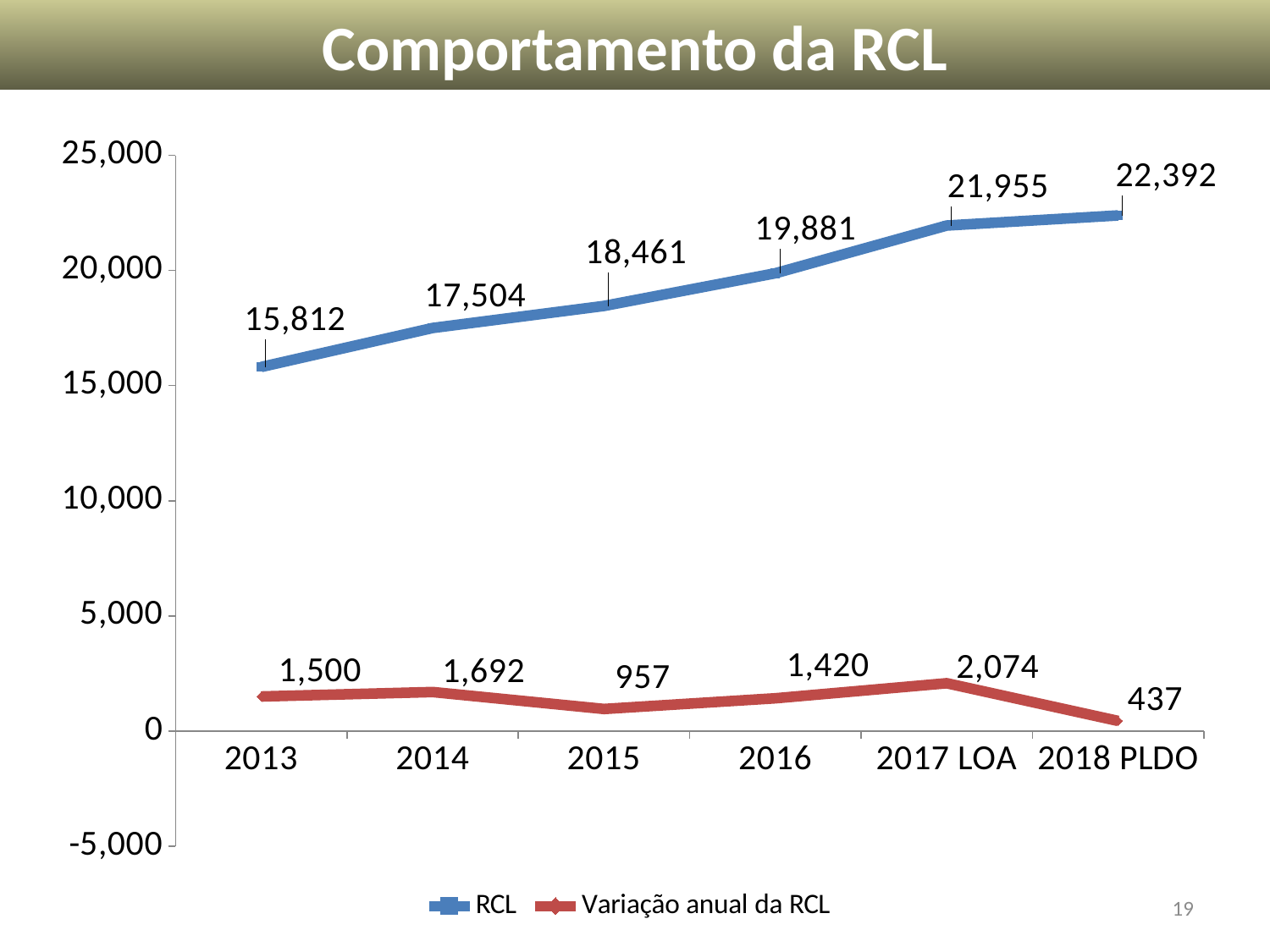
How many series does the legend list? 2 Which category has the lowest Variação anual da RCL value? 2018 PLDO Which is larger, the Variação anual da RCL for 2014 or for 2016? 2014 What is the RCL value for 2018 PLDO? 22,392 What kind of chart is shown on the slide? line chart What is the value of Variação anual da RCL for 2017 LOA? 2,074 Does the RCL series rise or fall from 2013 to 2018 PLDO? rise Which category has the highest RCL value? 2018 PLDO How many categories are shown on the x axis? 6 What is the RCL value for 2015? 18,461 Is the RCL value for 2013 greater or less than 15,000? greater What is the difference between the RCL values for 2017 LOA and 2016? 2,074